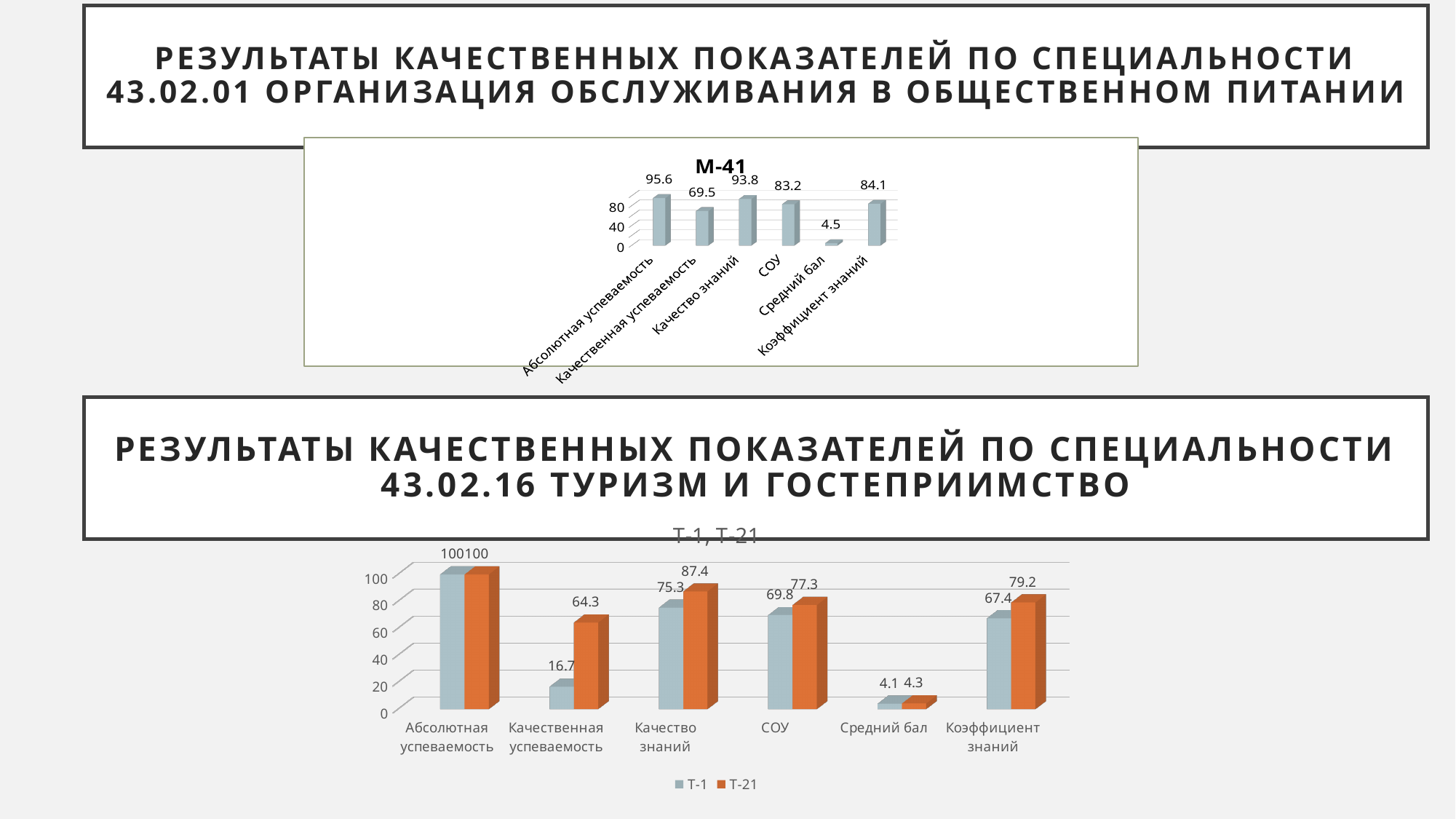
What kind of chart is the bottom chart titled Т-1, Т-21? Bar chart In the bottom chart titled Т-1, Т-21, what is the difference between the Т-21 and Т-1 values for Качественная успеваемость? 47.6 In the top chart titled М-41, what is the value for Абсолютная успеваемость? 95.6 In the bottom chart titled Т-1, Т-21, what is the Т-21 value for Качественная успеваемость? 64.3 In the bottom chart titled Т-1, Т-21, which colour represents the Т-21 series? Orange In the bottom chart titled Т-1, Т-21, which is larger for СОУ: Т-1 or Т-21? Т-21 In the top chart titled М-41, which category has the lowest value? Средний бал In the top chart titled М-41, how many categories are shown on the x axis? 6 In the bottom chart titled Т-1, Т-21, how many series does the legend list? 2 In the bottom chart titled Т-1, Т-21, what is the Т-1 value for Коэффициент знаний? 67.4 In the top chart titled М-41, what is the difference between Качество знаний and Качественная успеваемость? 24.3 In the top chart titled М-41, what is the value for Средний бал? 4.5